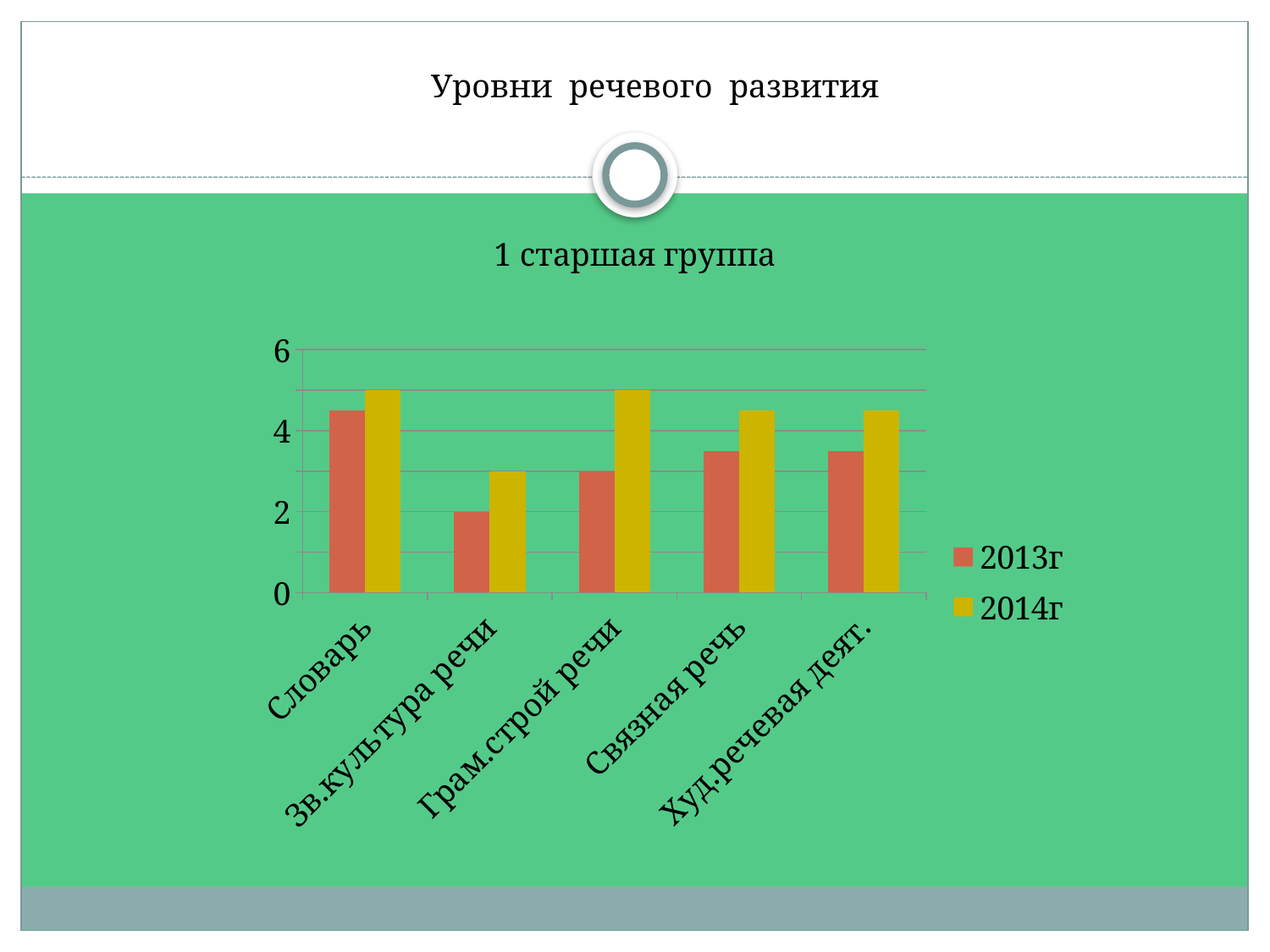
Is the value for Словарь in the 2013г series greater or less than 4? greater How many categories are shown on the x axis of the chart? 5 Which category has the lowest value in the 2013г series? Зв.культура речи Is the value for Связная речь in the 2013г series greater or less than 4? less Which category has the lowest value in the 2014г series? Зв.культура речи What is the value for Зв.культура речи in the 2013г series? 2 Which series is shown in yellow in the legend? 2014г What is the title of the chart? 1 старшая группа What kind of chart is shown on the slide? bar chart How many series does the legend list? 2 For Грам.строй речи, which series has the larger value, 2013г or 2014г? 2014г Which category has the highest value in the 2013г series? Словарь